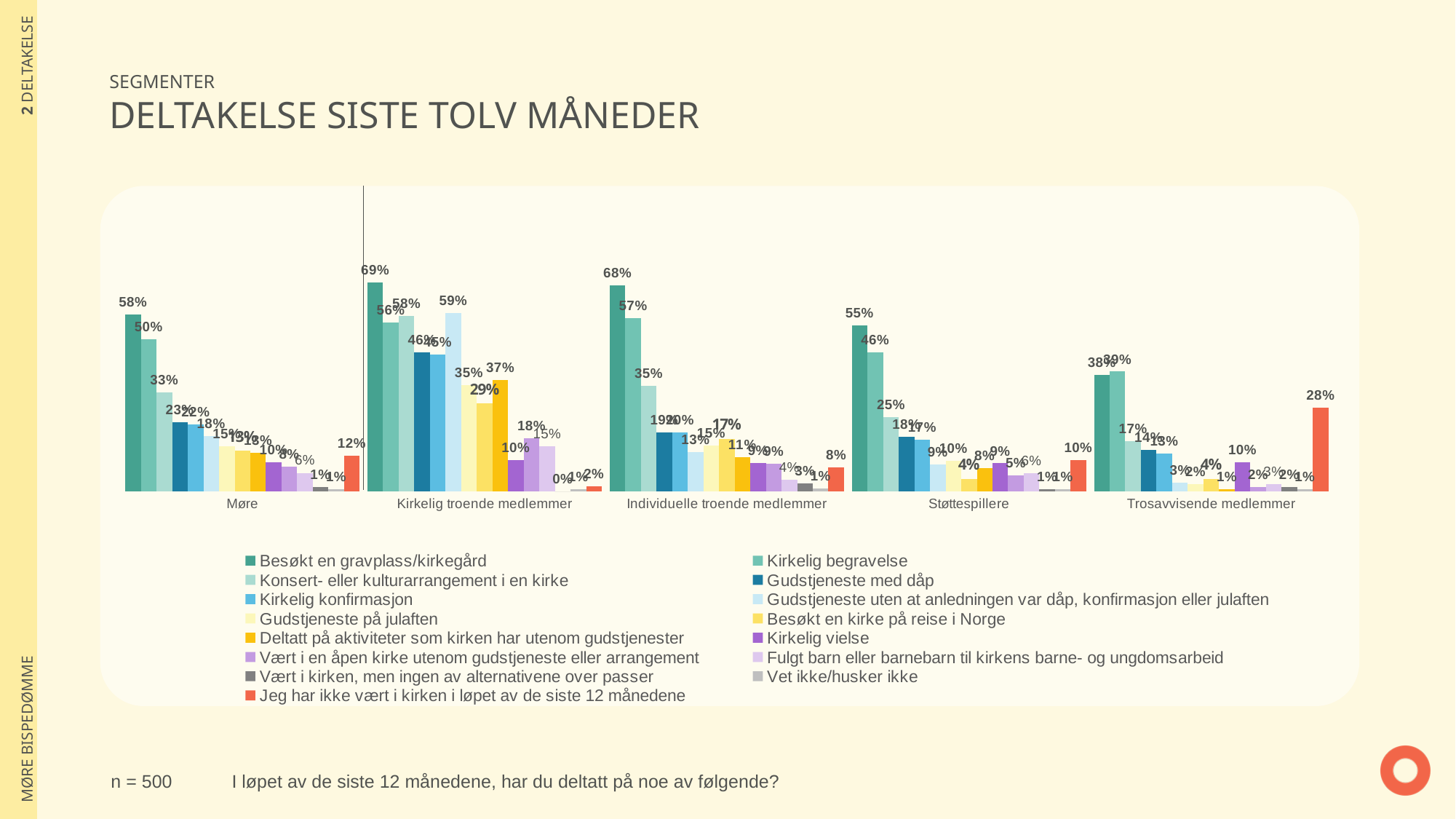
What is the value for 'Besøkt en gravplass/kirkegård' in the 'Støttespillere' group? 55% What kind of chart is shown on the slide? Bar chart How many series does the legend list? 15 Which group has the lowest value for 'Besøkt en gravplass/kirkegård'? Trosavvisende medlemmer What is the value for 'Jeg har ikke vært i kirken i løpet av de siste 12 månedene' in the 'Møre' group? 12% Which is larger: 'Jeg har ikke vært i kirken i løpet av de siste 12 månedene' for 'Trosavvisende medlemmer' or for 'Støttespillere'? Trosavvisende medlemmer What is the value for 'Besøkt en gravplass/kirkegård' in the 'Møre' group? 58% How many segment categories are shown along the x axis? 5 What is the value for 'Besøkt en gravplass/kirkegård' in the 'Kirkelig troende medlemmer' group? 69% What is the value for 'Jeg har ikke vært i kirken i løpet av de siste 12 månedene' in the 'Trosavvisende medlemmer' group? 28% What is the difference between 'Besøkt en gravplass/kirkegård' for 'Kirkelig troende medlemmer' (69%) and for 'Møre' (58%)? 11 percentage points Which group has the highest value for 'Besøkt en gravplass/kirkegård'? Kirkelig troende medlemmer